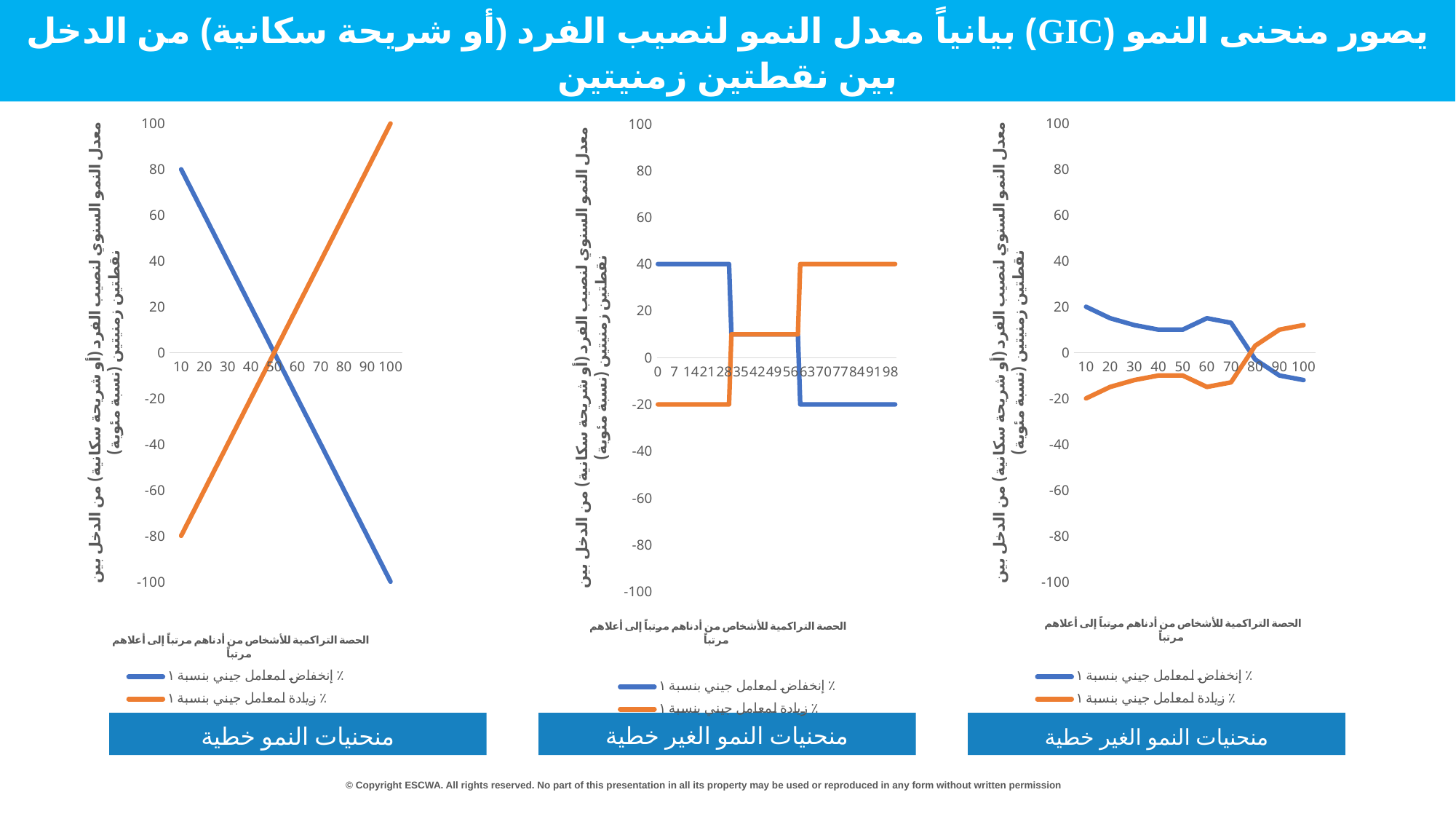
In the left chart, what is the value of the orange line (زيادة لمعامل جيني بنسبة ١٪) at x = 100? 100 What kind of chart is the left chart (منحنيات النمو خطية)? line chart In the left chart, does the blue line rise or fall as x increases? fall In the middle chart, which line is higher at x = 0, the blue line or the orange line? blue line How many series does the legend of the left chart list? 2 In the left chart, what is the value of the blue line at x = 100? -100 In the left chart, does the orange line rise or fall as x increases? rise In the middle chart, what is the value of the orange line at x = 98? 40 In the middle chart, what is the value of the blue line at x = 0? 40 In the right chart, what is the value of the blue line at x = 10? 20 In the left chart, what is the value of the blue line (إنخفاض لمعامل جيني بنسبة ١٪) at x = 10? 80 In the right chart, is the value of the orange line at x = 100 greater or less than 0? greater